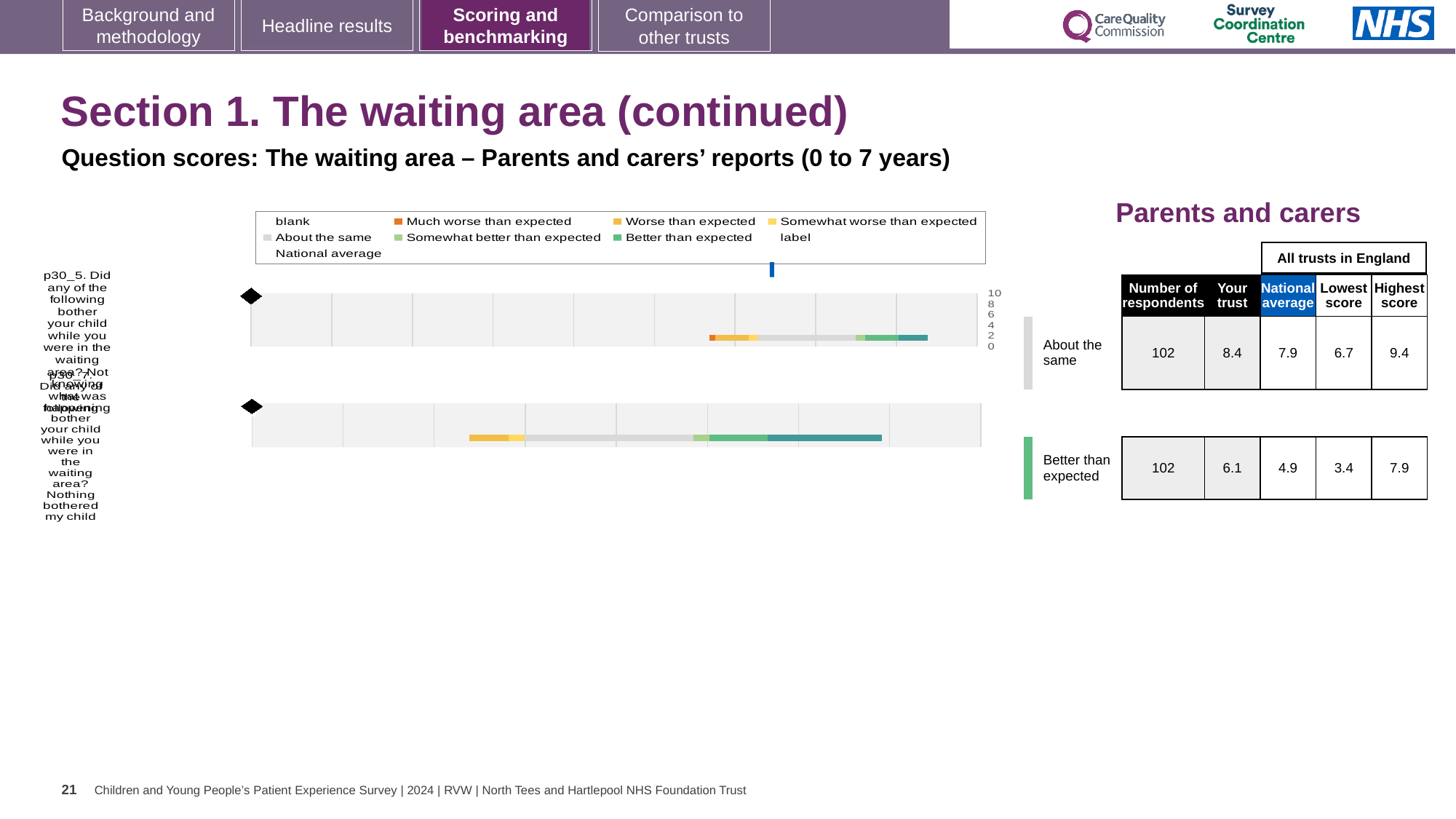
What is the lowest score across all trusts in England for the question rated 'Better than expected'? 3.4 How many entries does the chart legend list? 9 How many question bars are plotted in the chart? 2 How many respondents answered the question rated 'Better than expected'? 102 What is the 'Your trust' score for the question rated 'About the same' (p30_5)? 8.4 What is the national average for the question rated 'Better than expected'? 4.9 What is the 'Your trust' score for the question rated 'Better than expected' (p30_7)? 6.1 What is the difference between the trust score and the national average for the question rated 'Better than expected'? 1.2 What is the national average for the question rated 'About the same'? 7.9 Which question has the higher 'Your trust' score: the one rated 'About the same' or the one rated 'Better than expected'? About the same What kind of chart is shown on the slide? bar chart What is the highest score across all trusts in England for the question rated 'About the same'? 9.4